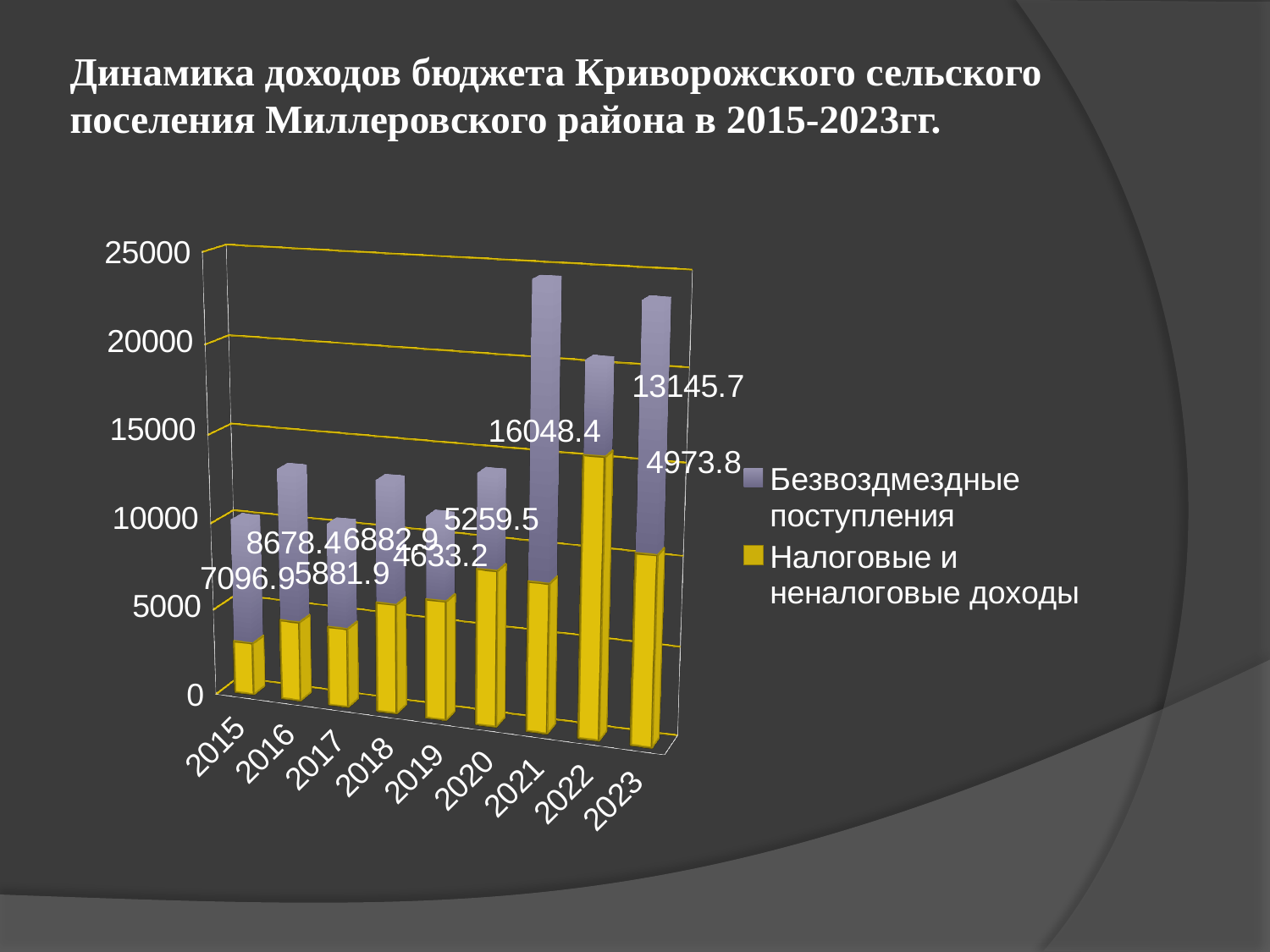
Which series is shown in yellow in the legend? Налоговые и неналоговые доходы How many series does the legend list? 2 How many years are shown on the x axis of the chart? 9 Is the value for 'Налоговые и неналоговые доходы' in 2021 greater or less than 10000? less Does the total bar rise or fall from 2020 to 2021? rise Is the total bar for 2015 greater or less than 15000? less What kind of chart is shown on the slide? stacked bar chart Which year has the tallest total bar? 2021 Is the value for 'Налоговые и неналоговые доходы' in 2022 greater or less than 10000? greater Which year has the largest value for 'Налоговые и неналоговые доходы'? 2022 Which year has the larger total bar, 2016 or 2021? 2021